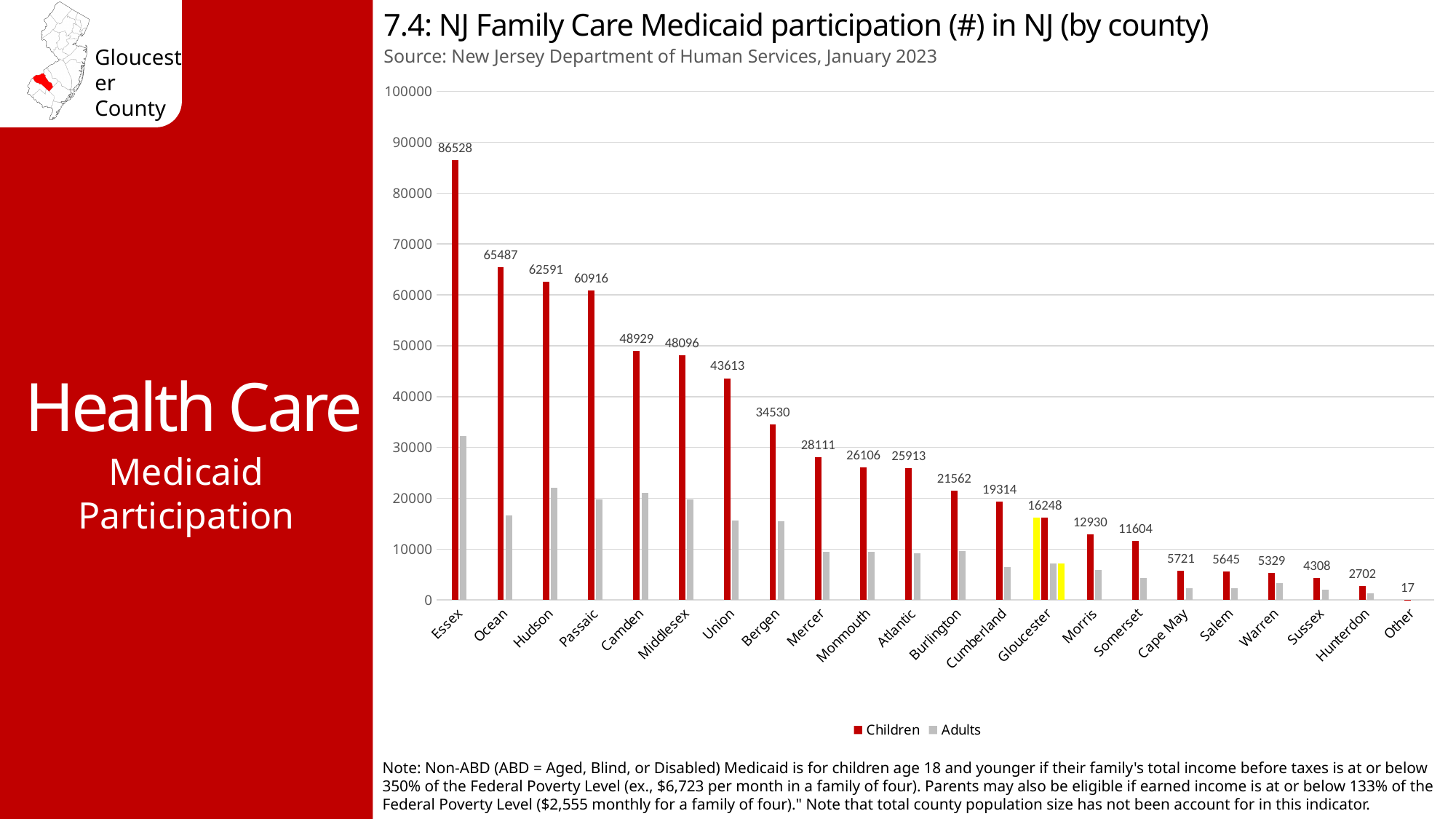
Is the Adults value for Essex greater or less than 30000? greater What is the difference between the Children values for Ocean and Hudson? 2896 How many series does the legend list? 2 What is the Children value for Hunterdon? 2702 What kind of chart is shown on the slide? Bar chart What is the Children value for Essex? 86528 How many categories are shown on the x axis? 22 Which has a larger Children value, Camden or Union? Camden What is the Children value for Gloucester? 16248 Is the Adults value for Gloucester greater or less than 10000? less Which county has the highest Children value? Essex Which category has the lowest Children value? Other